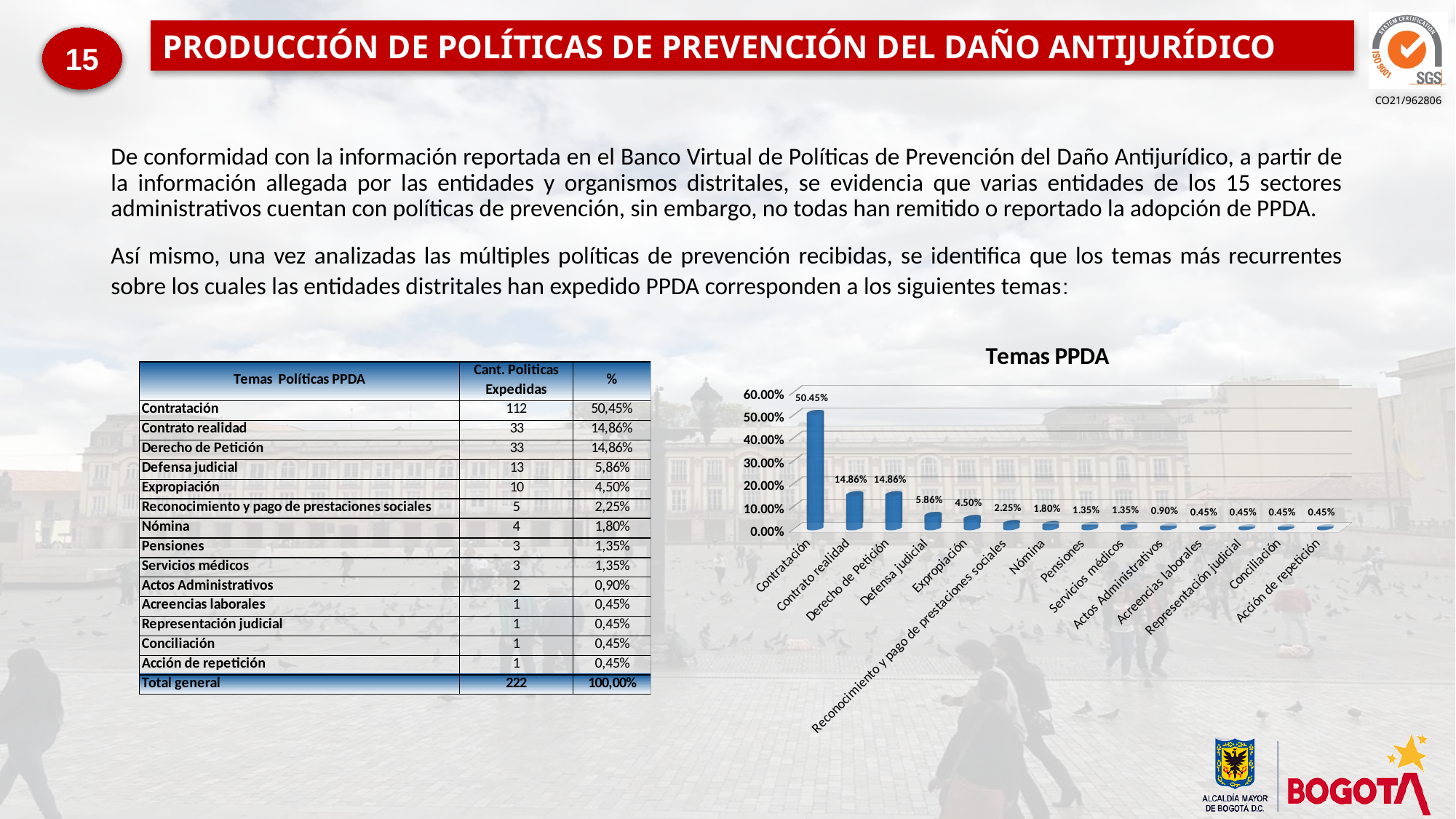
In the Temas PPDA chart, what is the value for Nómina? 1.80% In the Temas PPDA chart, what is the difference between the values for Contratación and Contrato realidad? 35.59% In the Temas PPDA chart, what is the difference between the values for Defensa judicial and Expropiación? 1.36% How many categories are shown on the x axis of the Temas PPDA chart? 14 What type of chart is shown under the title Temas PPDA? bar chart In the Temas PPDA chart, do the values rise or fall from left to right along the x axis? fall In the Temas PPDA chart, what is the value for Contratación? 50.45% In the Temas PPDA chart, what is the value for Defensa judicial? 5.86% What is the title of the chart on the slide? Temas PPDA In the Temas PPDA chart, which is larger, the value for Expropiación or the value for Reconocimiento y pago de prestaciones sociales? Expropiación Which category has the highest value in the Temas PPDA chart? Contratación In the Temas PPDA chart, what is the value for Actos Administrativos? 0.90%